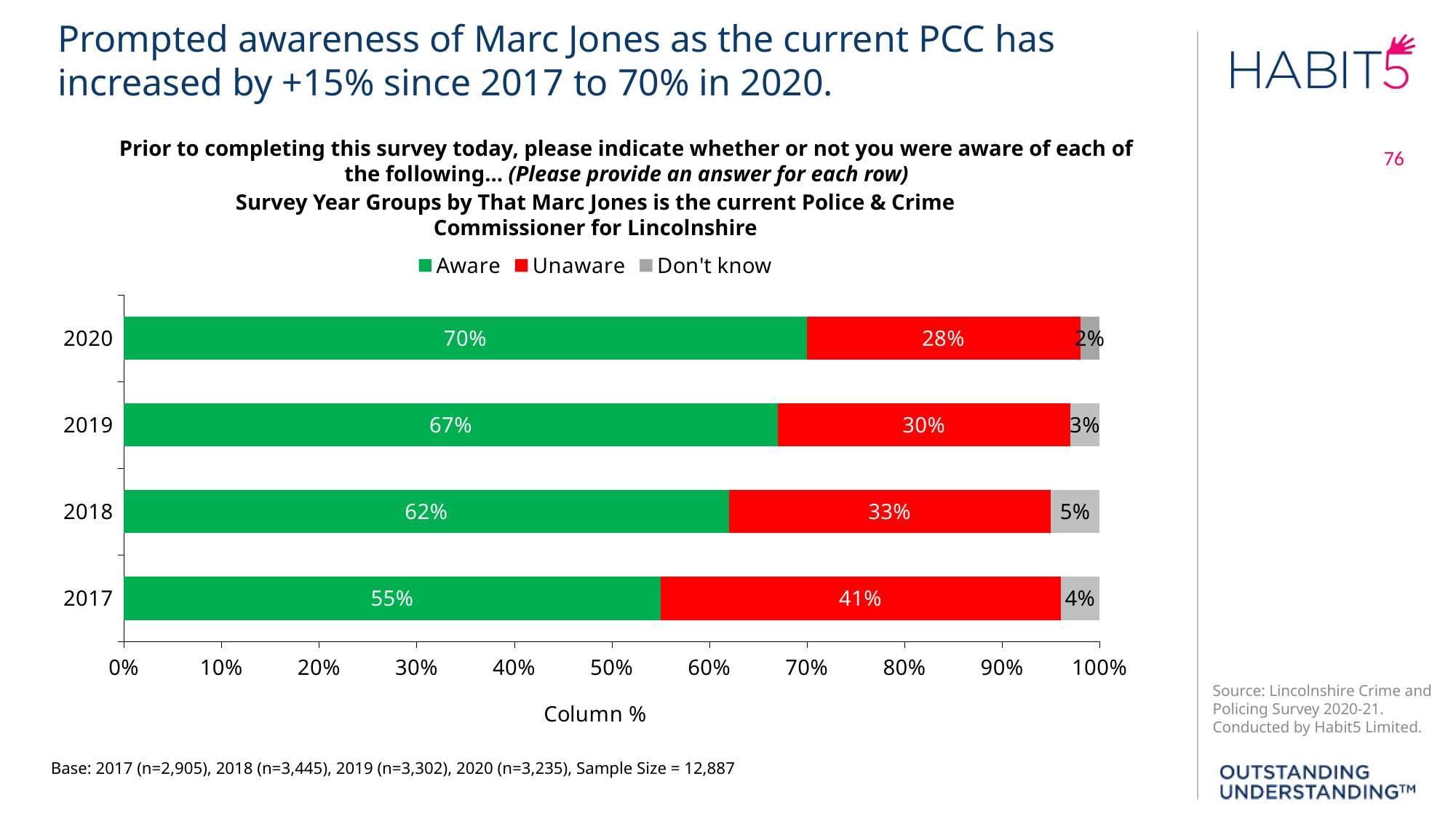
Does the Aware percentage rise or fall from 2017 to 2020? Rise How many series does the legend list? 3 What percentage of respondents were Unaware in 2017? 41% What percentage of respondents were Aware of Marc Jones as the current PCC in 2020? 70% What kind of chart is shown on the slide? Stacked bar chart Which survey year has the highest Aware percentage? 2020 How many survey years are shown on the chart? 4 What is the Don't know value for 2018? 5% What is the difference between the Aware percentage in 2020 and in 2017? 15% What colour represents the Unaware series in the chart? Red Which survey year has the lowest Aware percentage? 2017 Which is larger: the Unaware percentage in 2018 or in 2019? 2018